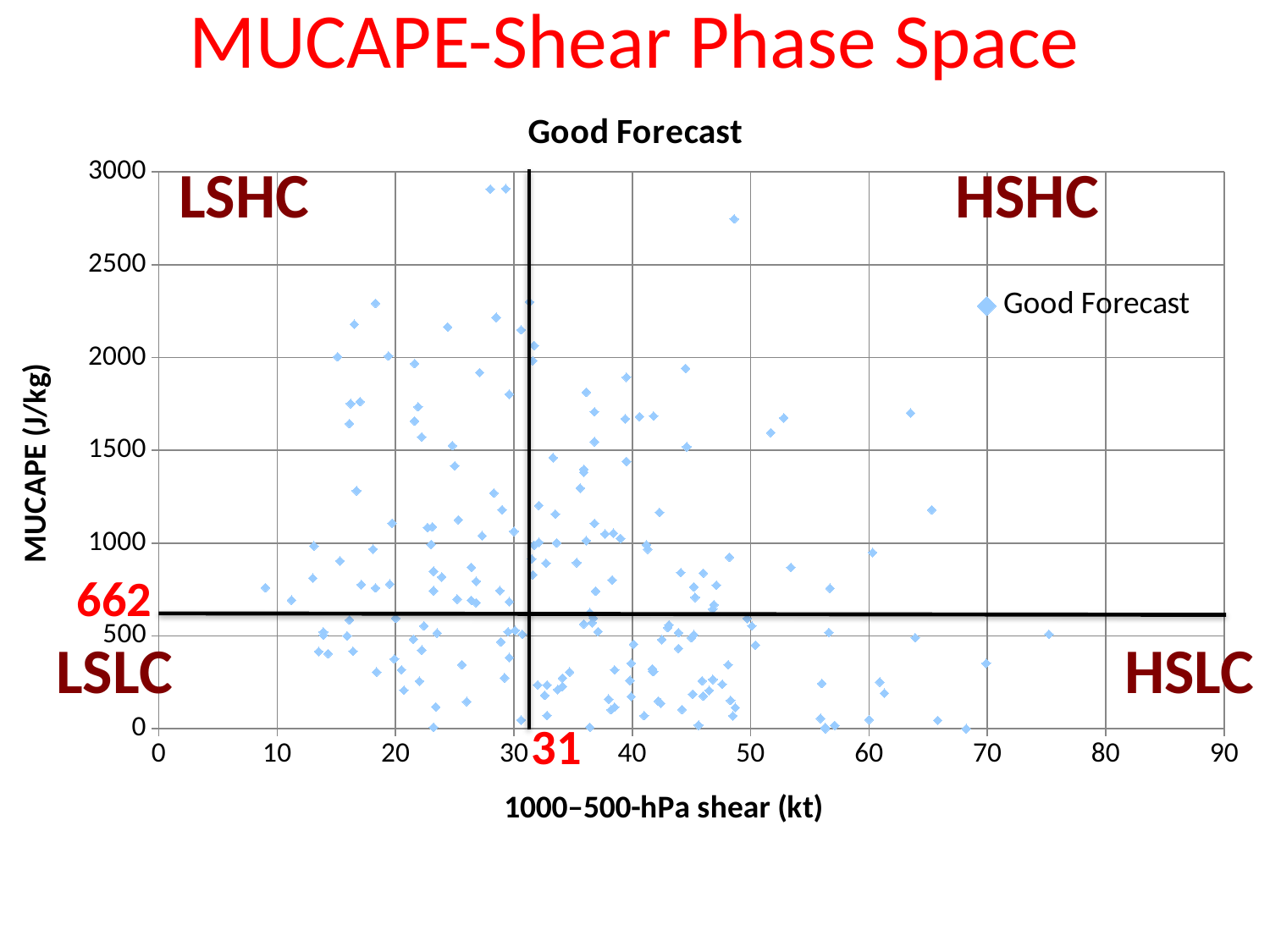
What is the name of the series shown in the legend? Good Forecast How many series does the legend list? 1 Is the highest MUCAPE value plotted greater or less than 2500? greater What is the title of the chart? Good Forecast Is the MUCAPE value of the point plotted near 75 kt shear greater or less than 1000? less Is the largest shear value plotted greater or less than 80? less What kind of chart is shown on the slide? scatter chart